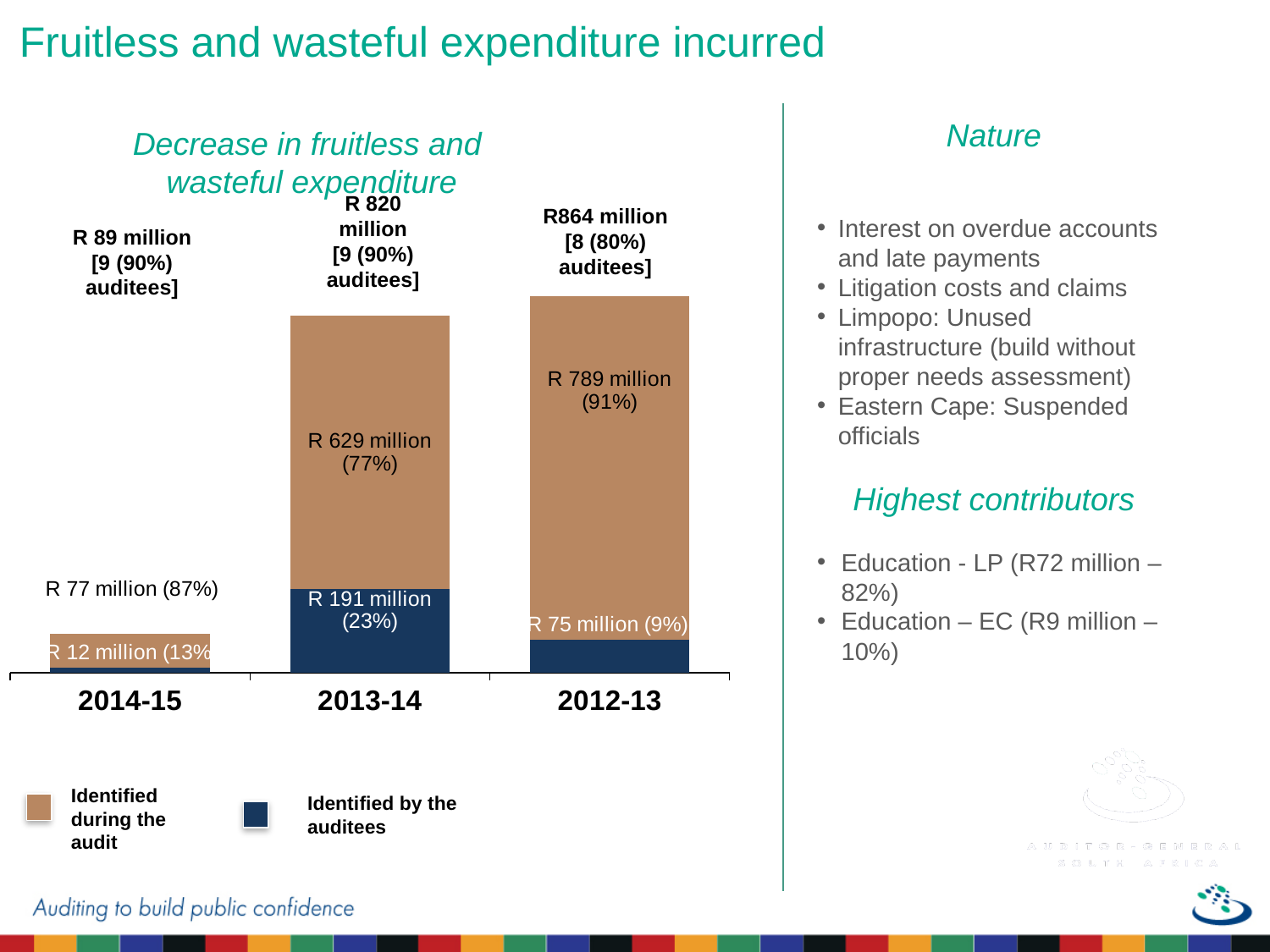
How many series does the legend list? 2 Which is larger: the amount identified by the auditees in 2013-14 or in 2012-13? 2013-14 What is the value identified during the audit for 2013-14? R 629 million (77%) How many financial years are shown on the x axis of the chart? 3 What is the value identified by the auditees for 2012-13? R 75 million (9%) Which year has the lowest total fruitless and wasteful expenditure? 2014-15 What type of chart is shown on the slide? Stacked bar chart Which year has the highest total fruitless and wasteful expenditure? 2012-13 What is the total fruitless and wasteful expenditure shown for 2014-15? R 89 million What is the total fruitless and wasteful expenditure shown for 2012-13? R864 million What is the difference between the amount identified during the audit in 2012-13 and in 2013-14? R 160 million Which series is shown in brown in the legend? Identified during the audit